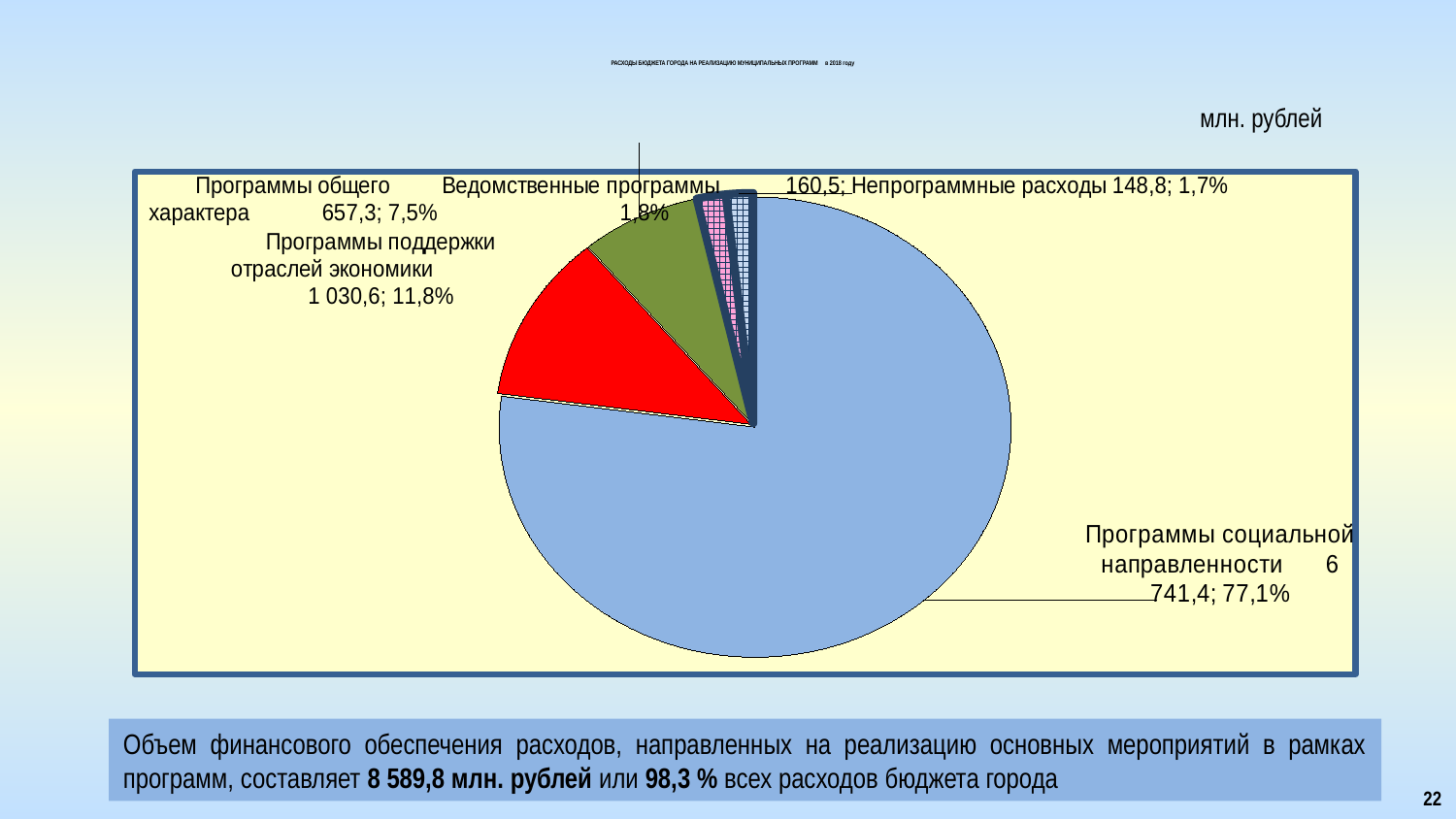
What is the value for Программы социальной направленности? 6 741,4 How many slices does the pie chart have? 5 What is the value for Программы поддержки отраслей экономики? 1 030,6 What is the value for Ведомственные программы? 160,5 What kind of chart is shown on the slide? pie chart In what units are the values on the chart given? млн. рублей What is the difference between the values for Программы поддержки отраслей экономики and Программы общего характера? 373,3 What share of the pie does Непрограммные расходы take? 1,7% What share of the pie does Программы социальной направленности take? 77,1% What share of the pie does Программы общего характера take? 7,5% Which category has the smallest slice? Непрограммные расходы Which category has the largest slice? Программы социальной направленности